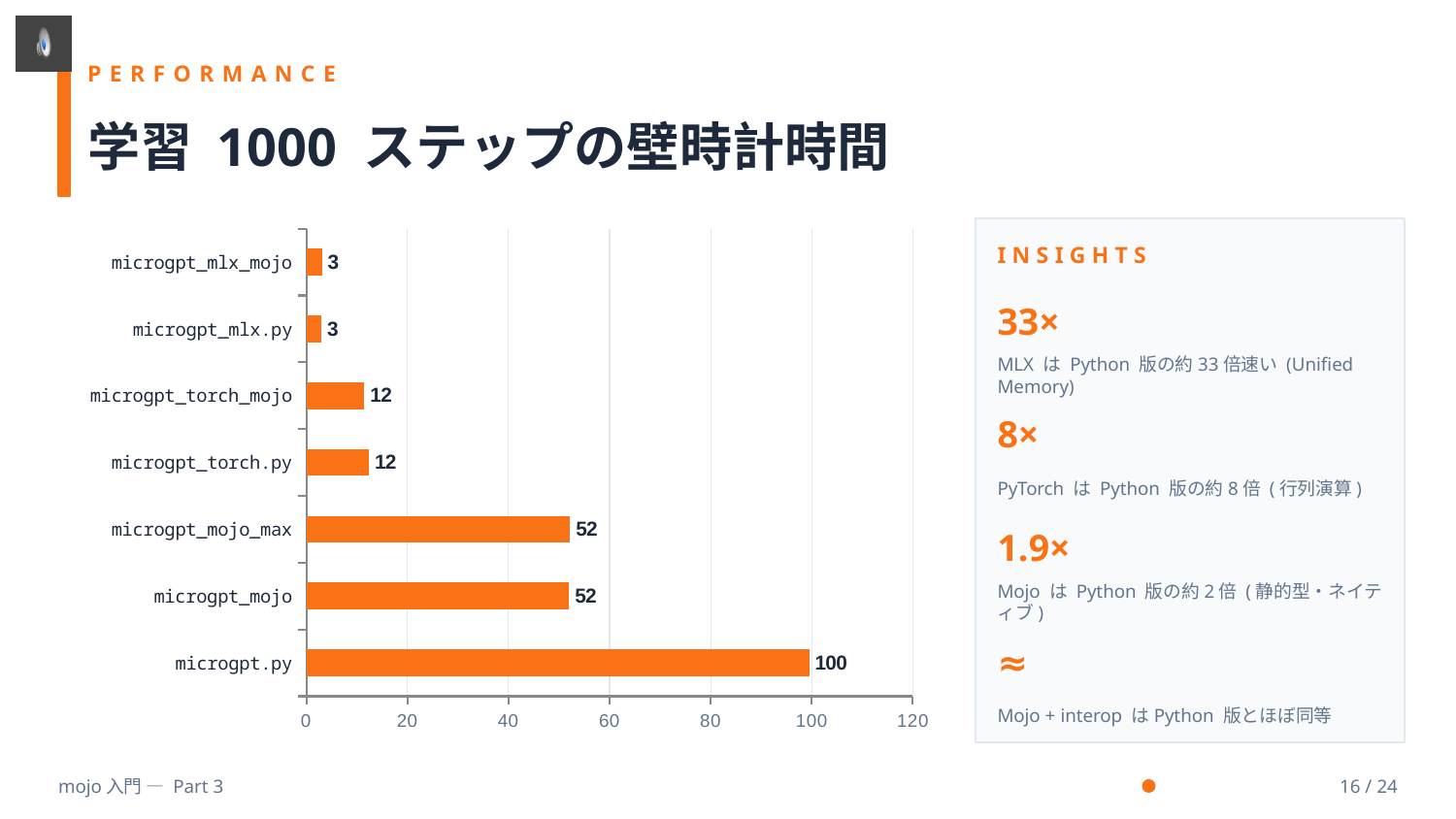
What is the maximum value shown on the horizontal axis? 120 What is the value for microgpt_mlx.py? 3 What is the value for microgpt_torch_mojo? 12 Which category has the highest value? microgpt.py Which is larger, the value for microgpt_mojo_max or the value for microgpt_torch.py? microgpt_mojo_max What kind of chart is shown on the slide? bar chart What colour are the bars in the chart? orange What is the difference between the values for microgpt_torch.py and microgpt_mlx_mojo? 9 Is the value for microgpt_mojo greater or less than 40? greater What is the difference between the values for microgpt.py and microgpt_mojo? 48 How many categories are shown in the chart? 7 What is the value for microgpt.py? 100